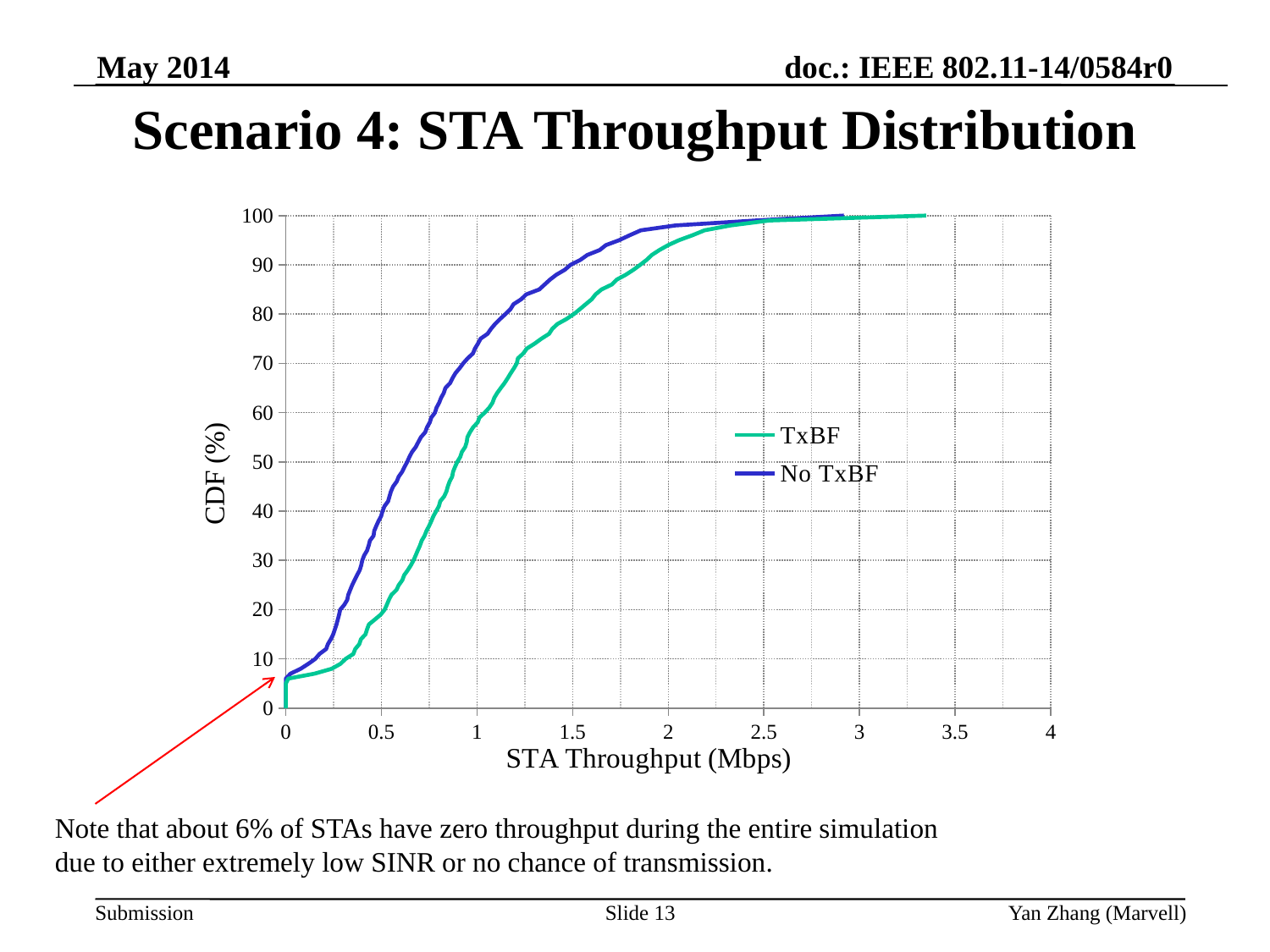
At a STA throughput of 1 Mbps, is the CDF value for TxBF greater or less than 50? greater What is the title of the chart? Scenario 4: STA Throughput Distribution At a STA throughput of 1 Mbps, is the CDF value for No TxBF greater or less than 70? greater What kind of chart is shown on the slide? Line chart At a STA throughput of 1 Mbps, which series has the higher CDF value, TxBF or No TxBF? No TxBF At a STA throughput of 0.5 Mbps, is the CDF value for TxBF greater or less than 30? less How many series does the legend list? 2 Do the CDF values rise or fall as STA throughput increases along the x axis? Rise What is the label of the x axis? STA Throughput (Mbps) Which series reaches 100% CDF at a higher STA throughput, TxBF or No TxBF? TxBF